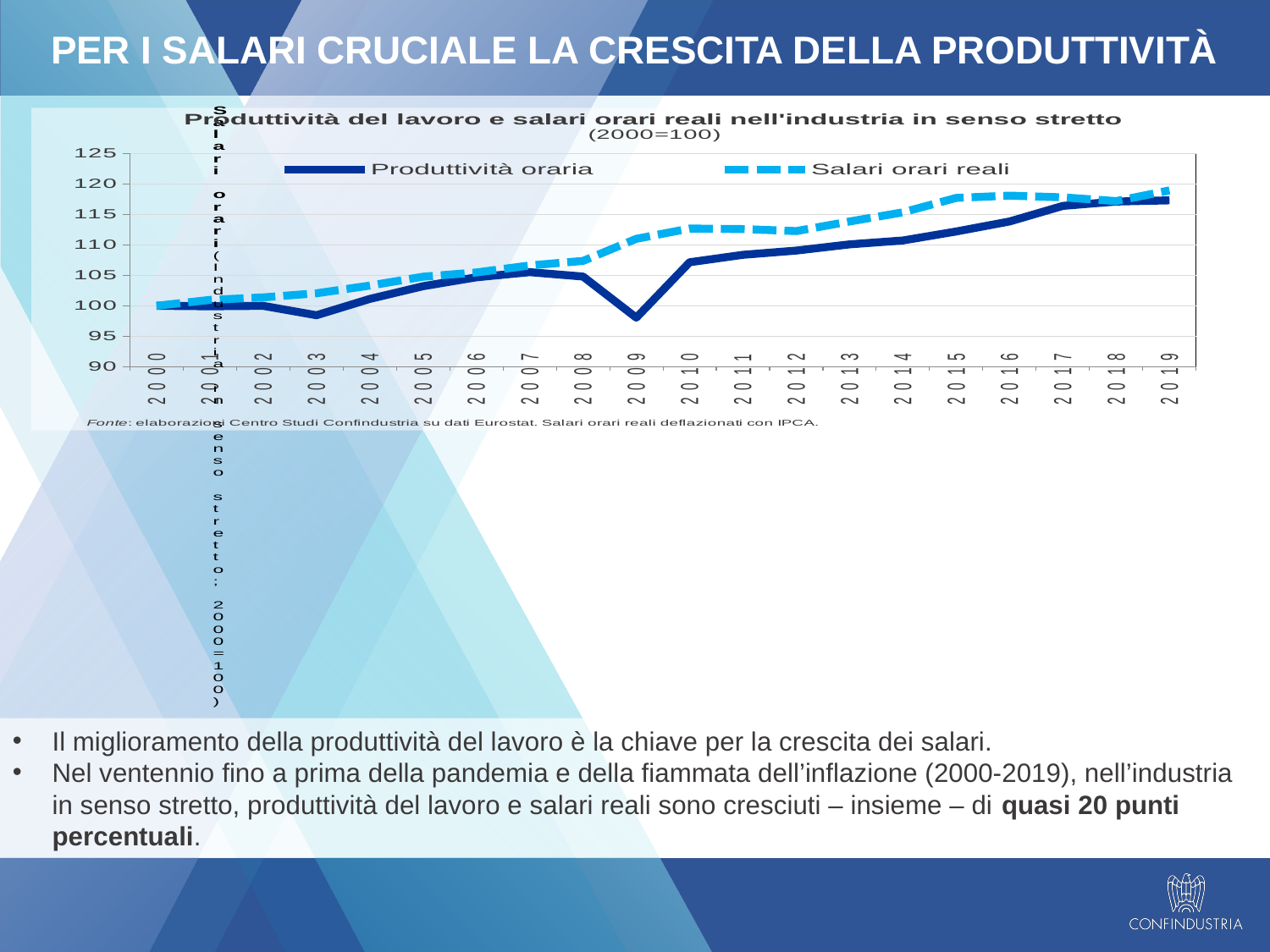
Is the value for Salari orari reali in 2019 greater or less than 115? greater In 2009, which series has the higher value, Produttività oraria or Salari orari reali? Salari orari reali In which year does the Produttività oraria series reach its lowest point? 2009 What are the two series named in the chart legend? Produttività oraria and Salari orari reali Is the value for Produttività oraria in 2009 greater or less than 100? less Is the value for Salari orari reali in 2010 greater or less than 110? greater How many series does the chart legend list? 2 What is the value of Produttività oraria in 2000? 100 How many years are shown on the x axis of the chart? 20 What base year is indicated in the chart subtitle? 2000=100 Overall, do the values of Salari orari reali rise or fall from 2000 to 2019? Rise What kind of chart is shown on the slide? Line chart